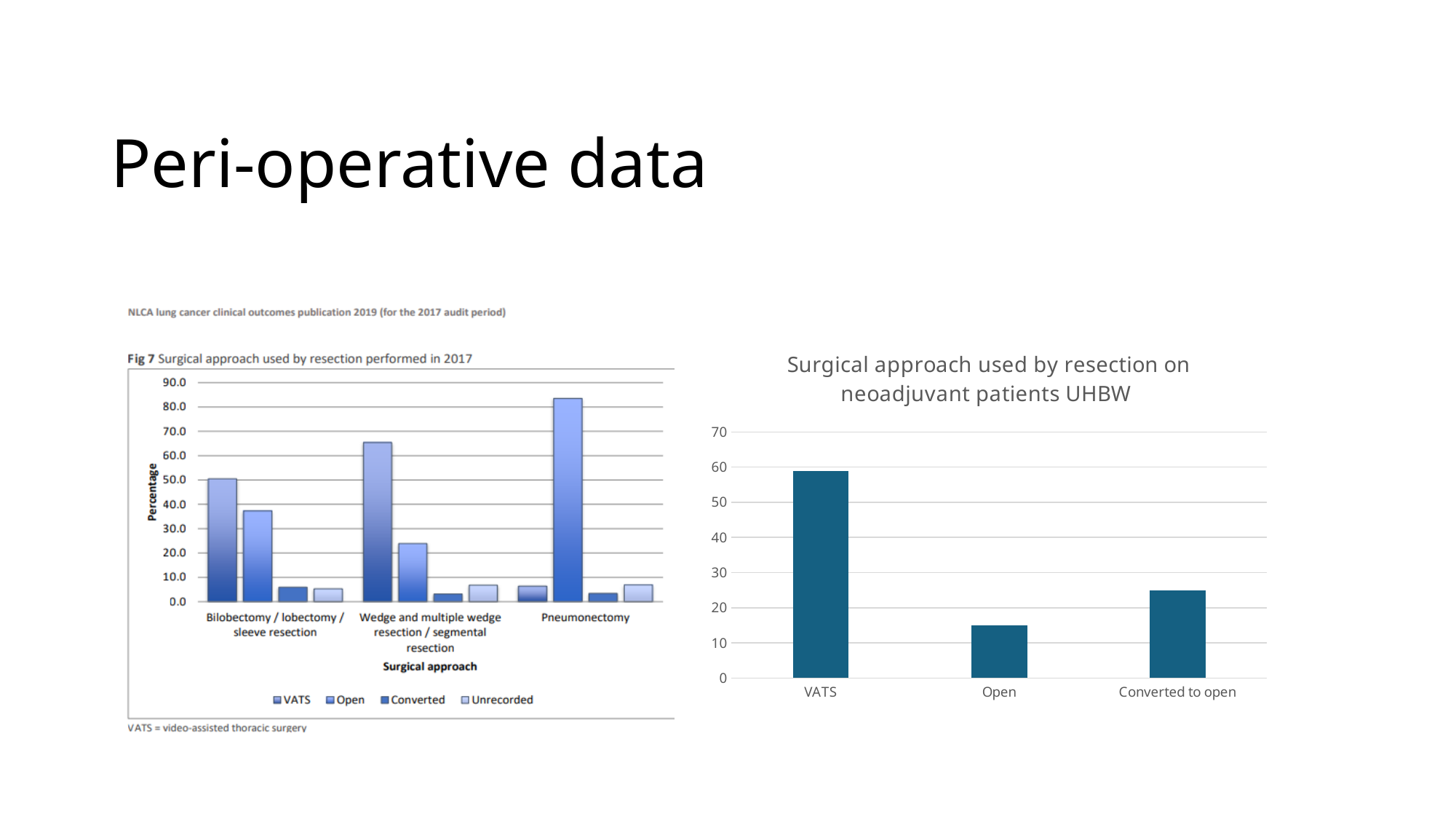
In the Fig 7 chart 'Surgical approach used by resection performed in 2017', is the Open value for Pneumonectomy greater or less than 80.0? greater In the 'Surgical approach used by resection on neoadjuvant patients UHBW' chart, which category has the highest value? VATS In the 'Surgical approach used by resection on neoadjuvant patients UHBW' chart, is the value for VATS greater or less than 50? greater In the Fig 7 chart 'Surgical approach used by resection performed in 2017', how many series does the legend list? 4 In the 'Surgical approach used by resection on neoadjuvant patients UHBW' chart, is the value for Converted to open greater or less than 20? greater In the 'Surgical approach used by resection on neoadjuvant patients UHBW' chart, how many categories are shown on the x axis? 3 What kind of chart is the 'Surgical approach used by resection on neoadjuvant patients UHBW' chart? bar chart In the Fig 7 chart 'Surgical approach used by resection performed in 2017', what is the label of the y axis? Percentage In the Fig 7 chart 'Surgical approach used by resection performed in 2017', which surgical approach has the highest percentage for Bilobectomy / lobectomy / sleeve resection? VATS In the 'Surgical approach used by resection on neoadjuvant patients UHBW' chart, which category has the lowest value? Open In the 'Surgical approach used by resection on neoadjuvant patients UHBW' chart, which is larger, Open or Converted to open? Converted to open